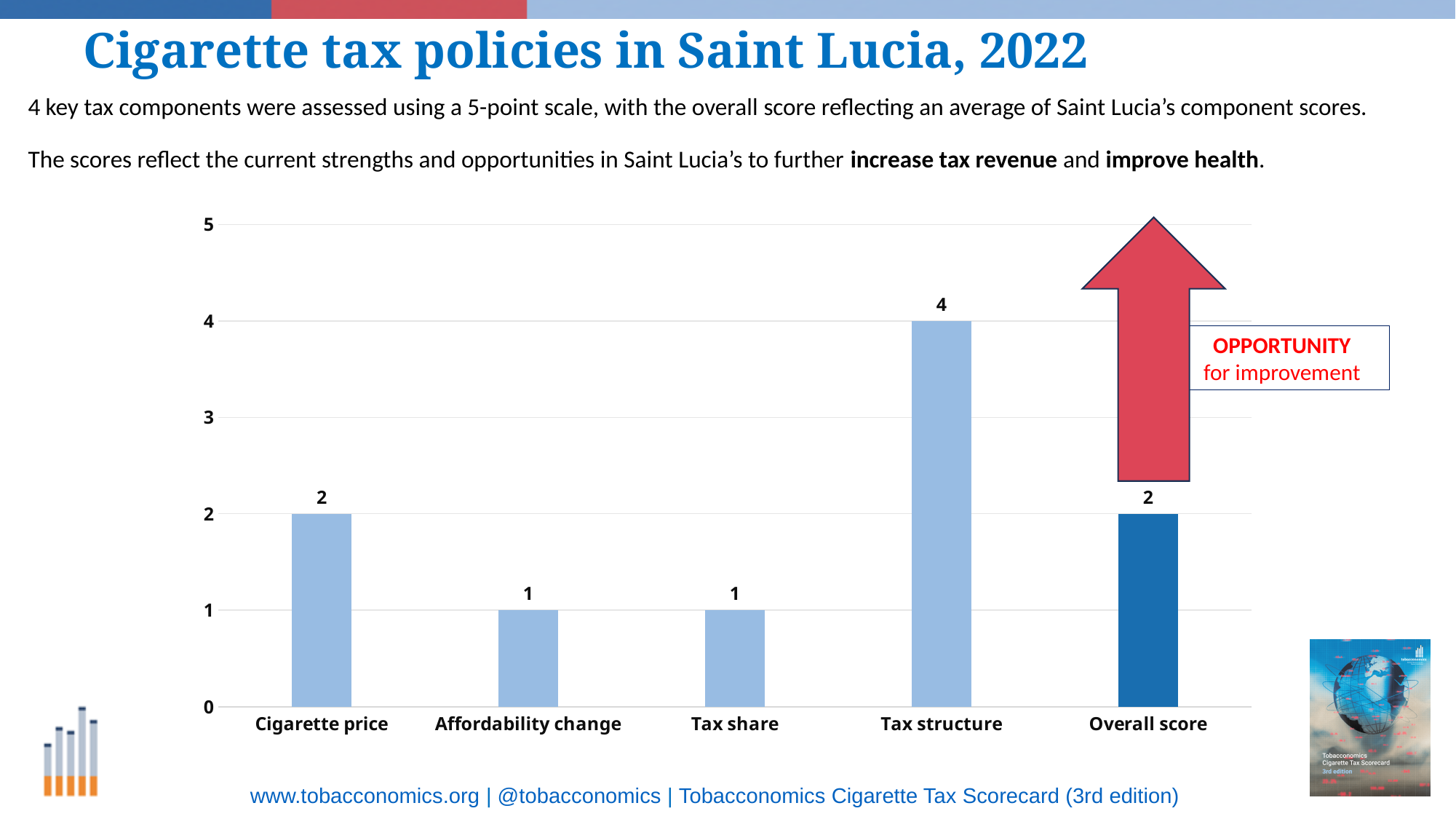
What is the score for Affordability change? 1 How many categories are shown on the x axis? 5 What is the score for Cigarette price? 2 What is the Overall score? 2 Which is larger, the score for Cigarette price or the score for Affordability change? Cigarette price Is the value for Tax structure greater or less than 3? greater What is the difference between the Tax structure score and the Tax share score? 3 What is the score for Tax structure? 4 What kind of chart is shown on the slide? bar chart Which bar is shown in a darker blue than the others? Overall score What is the maximum value shown on the y axis? 5 Which category has the highest score? Tax structure